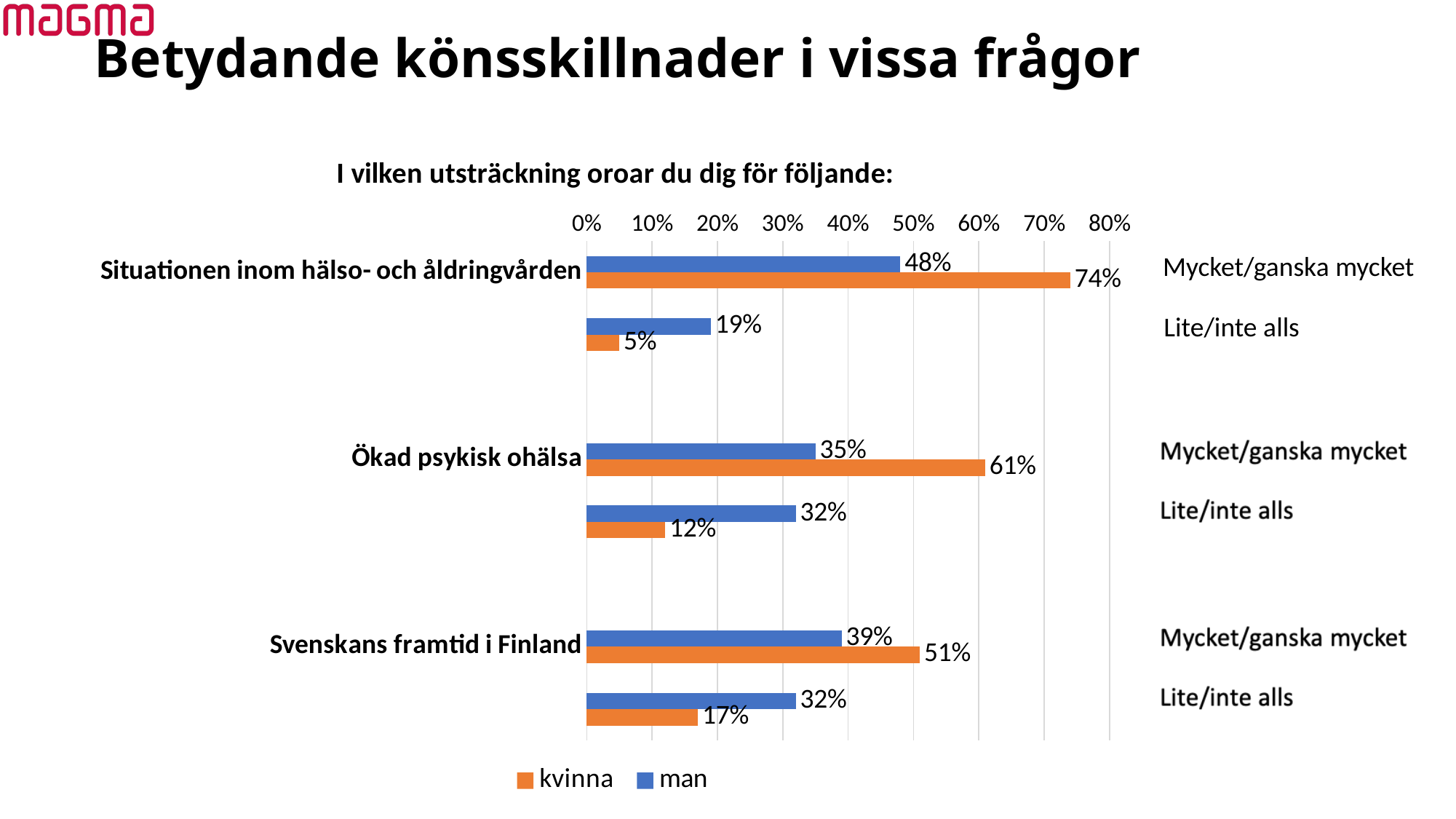
What is the value for man for 'Mycket/ganska mycket' under 'Situationen inom hälso- och åldringvården'? 48% What is the value for man for 'Mycket/ganska mycket' under 'Svenskans framtid i Finland'? 39% What is the value for kvinna for 'Lite/inte alls' under 'Ökad psykisk ohälsa'? 12% Which is larger for 'Lite/inte alls' under 'Svenskans framtid i Finland': kvinna or man? man Which bar has the lowest value in the chart? kvinna, Lite/inte alls, Situationen inom hälso- och åldringvården (5%) Which bar has the highest value in the chart? kvinna, Mycket/ganska mycket, Situationen inom hälso- och åldringvården (74%) What is the value for kvinna for 'Mycket/ganska mycket' under 'Situationen inom hälso- och åldringvården'? 74% What is the difference between kvinna and man for 'Lite/inte alls' under 'Situationen inom hälso- och åldringvården'? 14 percentage points What kind of chart is shown on the slide? Bar chart How many series does the legend list? 2 Which colour represents the series 'kvinna' in the chart? Orange What is the difference between kvinna and man for 'Mycket/ganska mycket' under 'Ökad psykisk ohälsa'? 26 percentage points